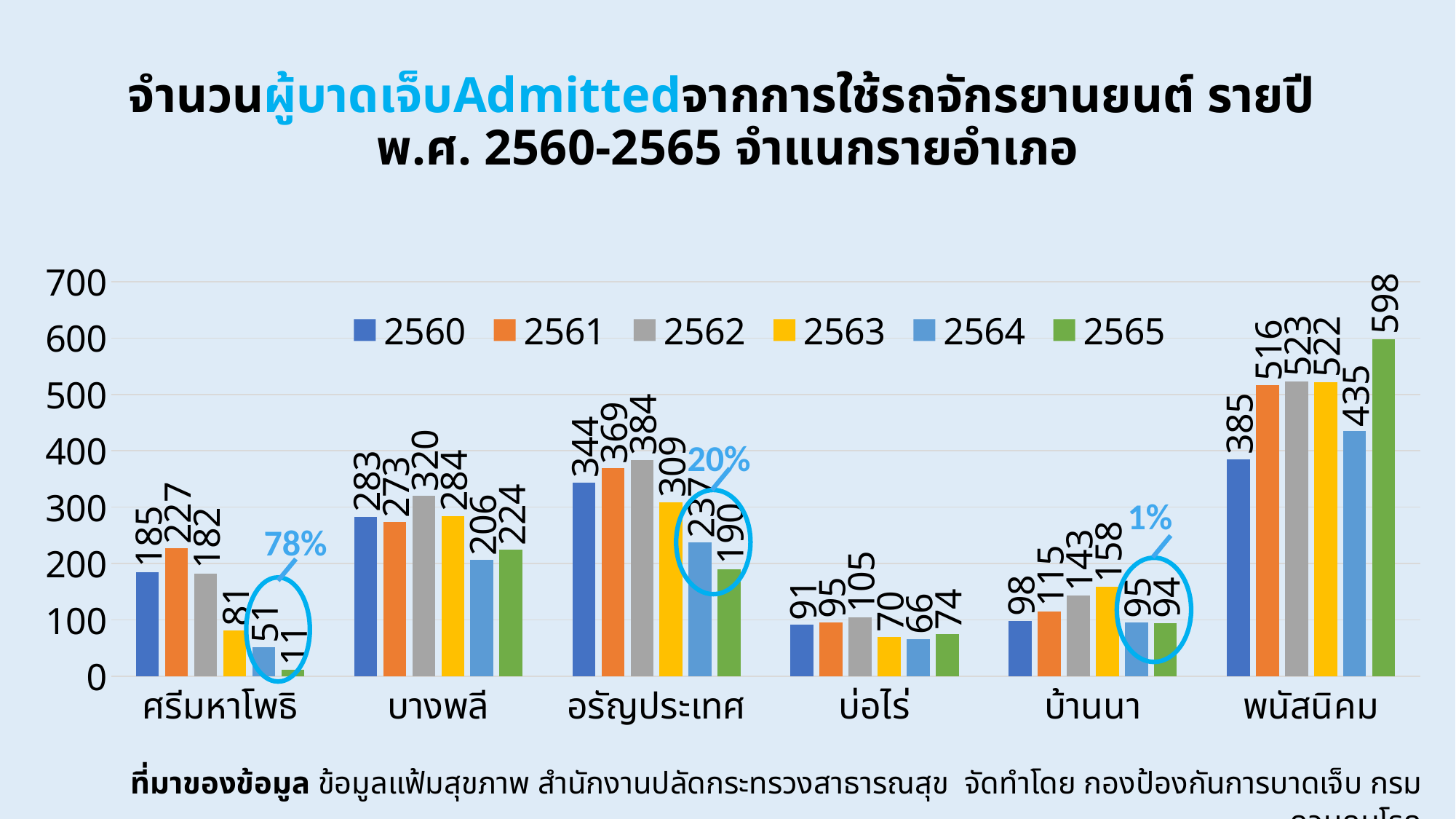
What is the value for บางพลี in 2562? 320 What percentage is annotated above the circled bars for ศรีมหาโพธิ? 78% What is the value for พนัสนิคม in 2565? 598 What is the difference between the 2564 and 2565 values for อรัญประเทศ? 47 Which district has the highest value in 2565? พนัสนิคม How many districts are shown on the x axis? 6 What is the value for ศรีมหาโพธิ in 2564? 51 Which district has the lowest value in 2565? ศรีมหาโพธิ Which is larger for บ้านนา: the 2563 value or the 2562 value? 2563 Do the values for ศรีมหาโพธิ rise or fall from 2562 to 2565? fall How many series does the legend list? 6 What kind of chart is shown on the slide? bar chart